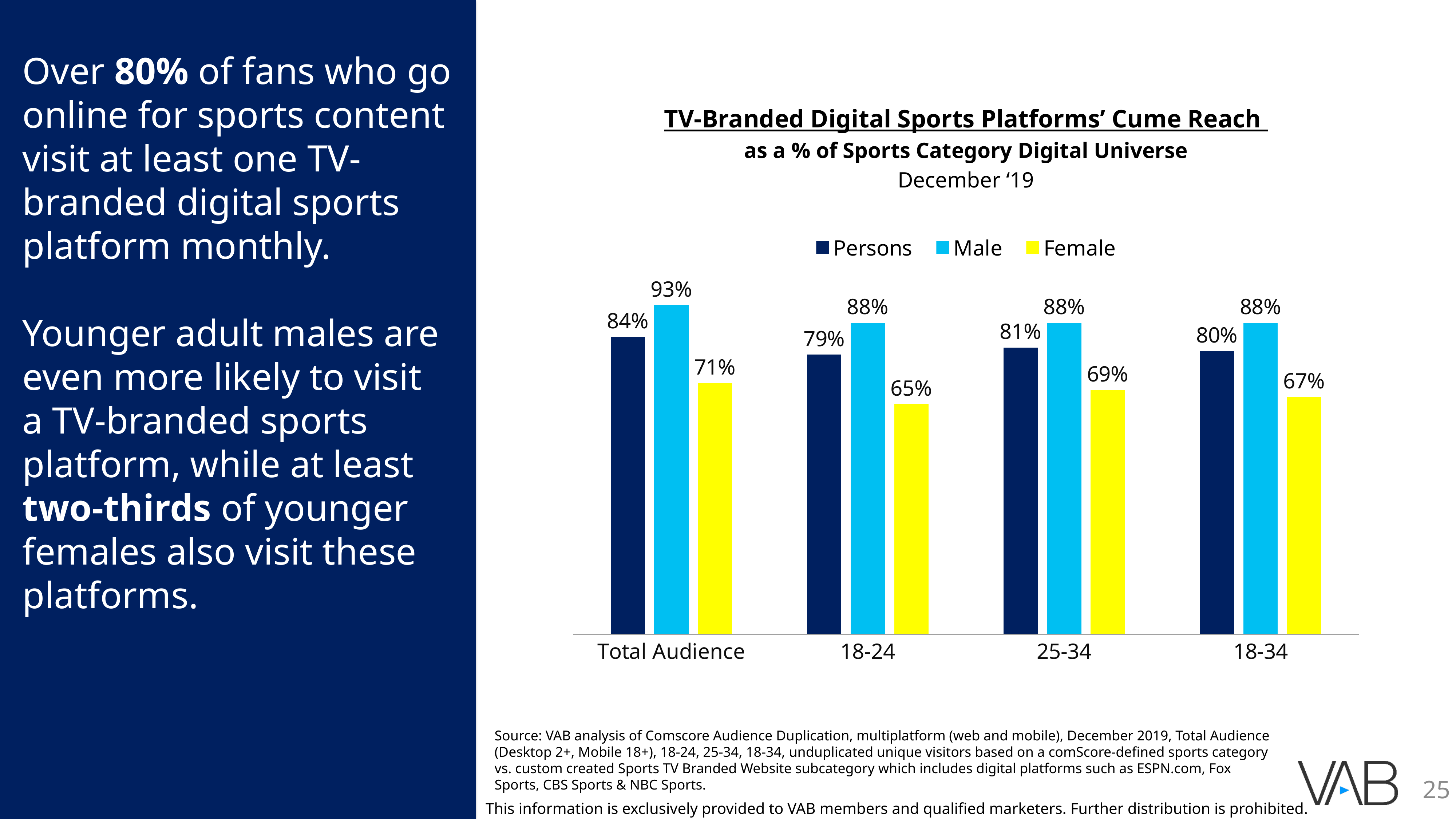
What is the Female value for the 18-34 group? 67% How many series does the legend list? 3 Which is larger, the Female value for 25-34 or the Female value for 18-34? 25-34 How many categories are shown on the x axis? 4 What is the difference between the Male and Female values for Total Audience? 22% Which category has the lowest Female value? 18-24 What kind of chart is shown on the slide? Bar chart What is the Persons value for the 25-34 group? 81% What is the Male value for Total Audience? 93% What is the Female value for the 18-24 group? 65% Which category has the highest Male value? Total Audience What is the difference between the Persons values for Total Audience and 18-24? 5%